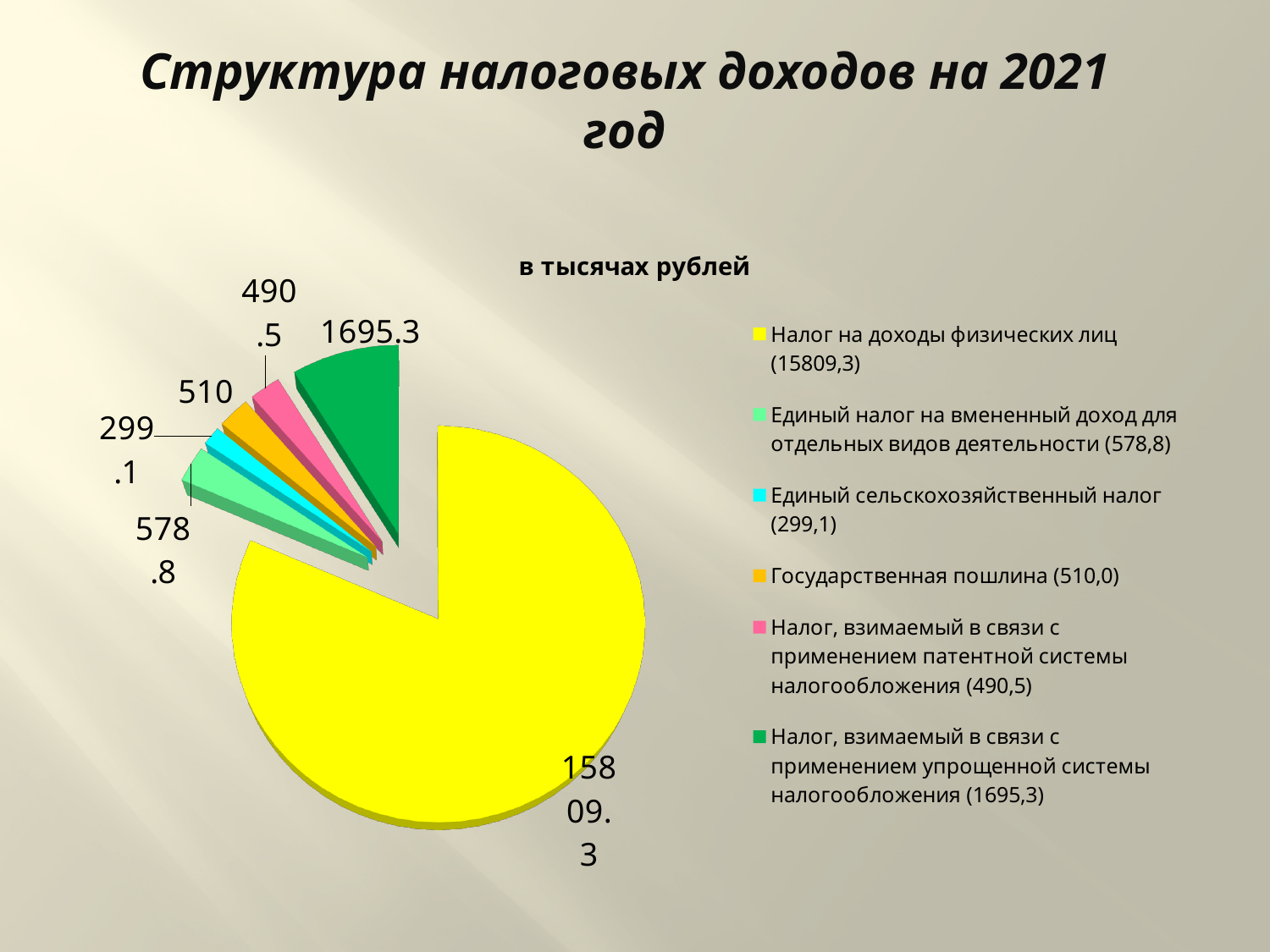
What is the value for Государственная пошлина? 510 Which category has the smallest slice of the pie? Единый сельскохозяйственный налог In what units are the values on the chart given, according to the text above the legend? в тысячах рублей Which category has the largest slice of the pie? Налог на доходы физических лиц What is the value for Единый сельскохозяйственный налог? 299.1 What is the value for Налог, взимаемый в связи с применением упрощенной системы налогообложения? 1695.3 Which is larger: Единый налог на вмененный доход or Государственная пошлина? Единый налог на вмененный доход What kind of chart is shown on the slide? pie chart How many slices does the pie chart have? 6 What is the difference between Государственная пошлина (510) and the патентная система налогообложения tax (490.5)? 19.5 What is the difference between the value for the упрощенная система налогообложения tax (1695.3) and Единый налог на вмененный доход (578.8)? 1116.5 What is the value for Налог на доходы физических лиц? 15809.3